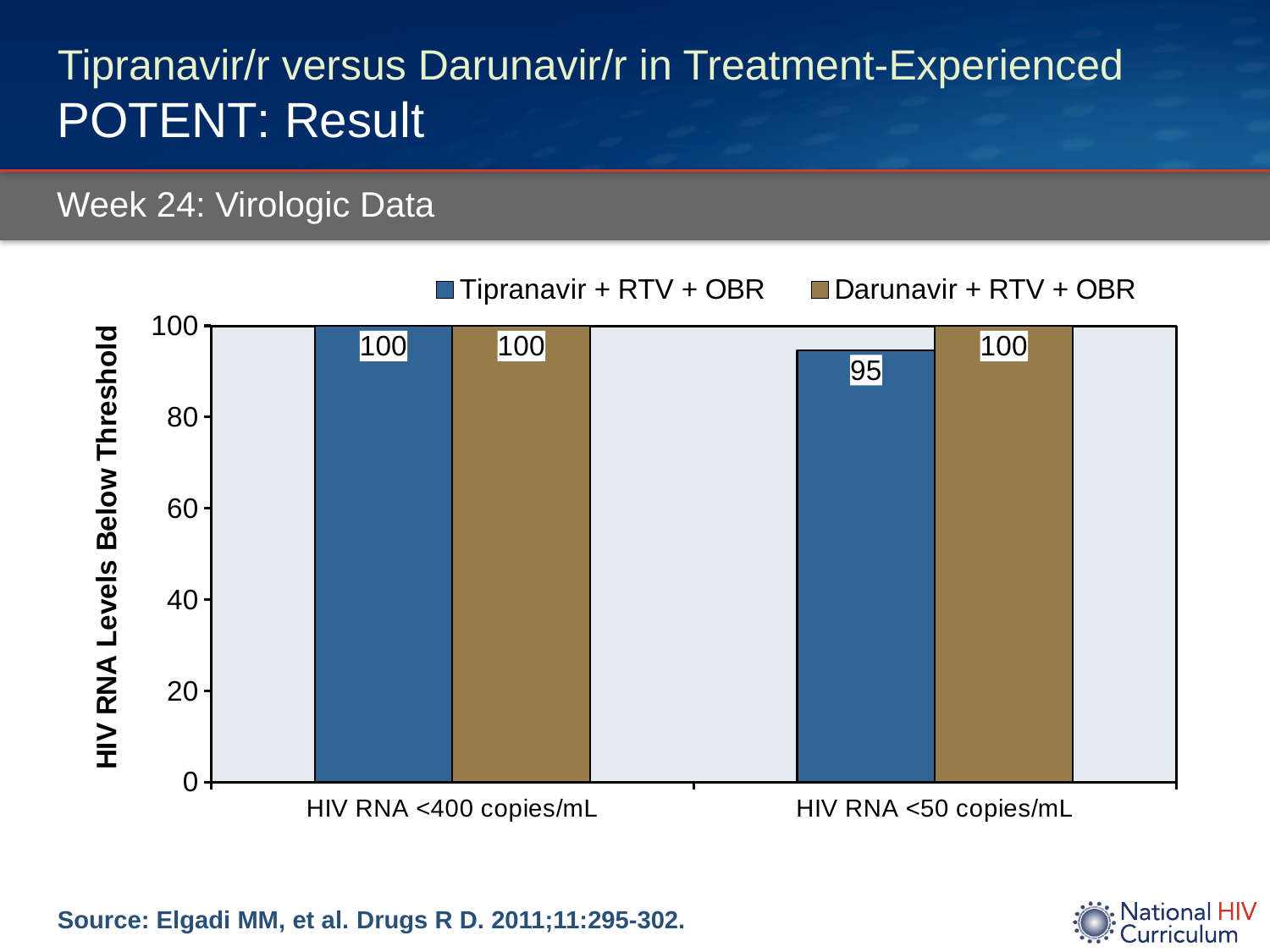
In the HIV RNA <50 copies/mL category, which series has the larger value, Tipranavir + RTV + OBR or Darunavir + RTV + OBR? Darunavir + RTV + OBR Is the value for Tipranavir + RTV + OBR in the HIV RNA <50 copies/mL category greater or less than 80? greater What is the value for Tipranavir + RTV + OBR in the HIV RNA <50 copies/mL category? 95 What is the value for Darunavir + RTV + OBR in the HIV RNA <400 copies/mL category? 100 What kind of chart is shown on the slide? bar chart What is the difference between the Darunavir + RTV + OBR and Tipranavir + RTV + OBR values in the HIV RNA <50 copies/mL category? 5 What is the label of the y axis? HIV RNA Levels Below Threshold Which series has the lowest value in the HIV RNA <50 copies/mL category? Tipranavir + RTV + OBR How many categories are shown on the x axis? 2 What is the value for Darunavir + RTV + OBR in the HIV RNA <50 copies/mL category? 100 How many series does the legend list? 2 What is the value for Tipranavir + RTV + OBR in the HIV RNA <400 copies/mL category? 100